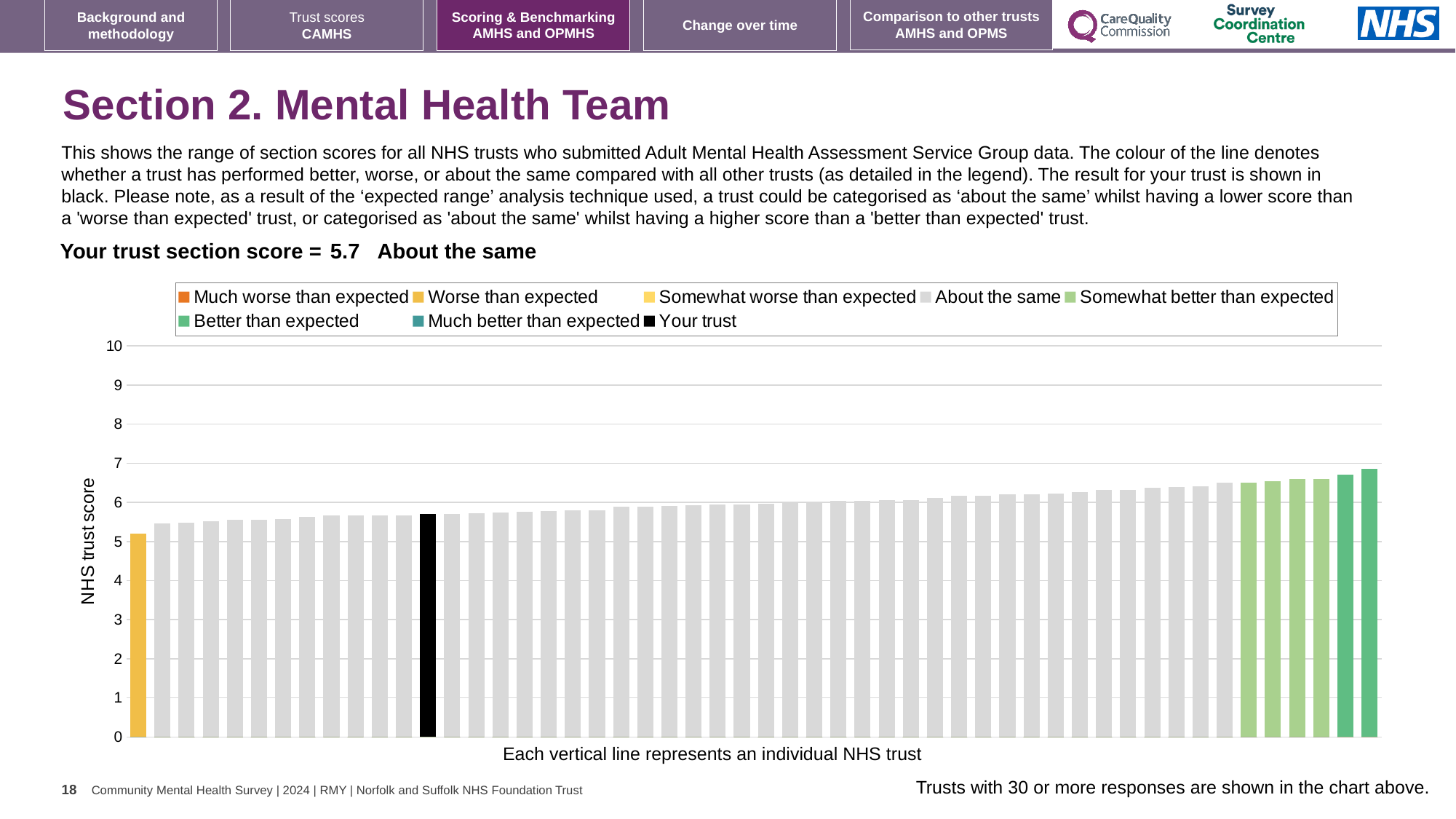
What is the label on the vertical axis of the chart? NHS trust score Do the bar values rise or fall from left to right across the chart? rise Is the value of the tallest bar in the chart greater or less than 7? less How many entries does the chart legend list? 8 Which is larger: the leftmost bar or the bar for your trust? the bar for your trust Which category is your trust placed in for this section? About the same What type of chart is shown on the slide? bar chart How many bars are coloured as 'Worse than expected' (yellow)? 1 Is the value for your trust greater or less than 6? less What is the section score for your trust shown on the slide? 5.7 Is the value of the leftmost bar in the chart greater or less than 5? greater What colour is the bar representing your trust? black